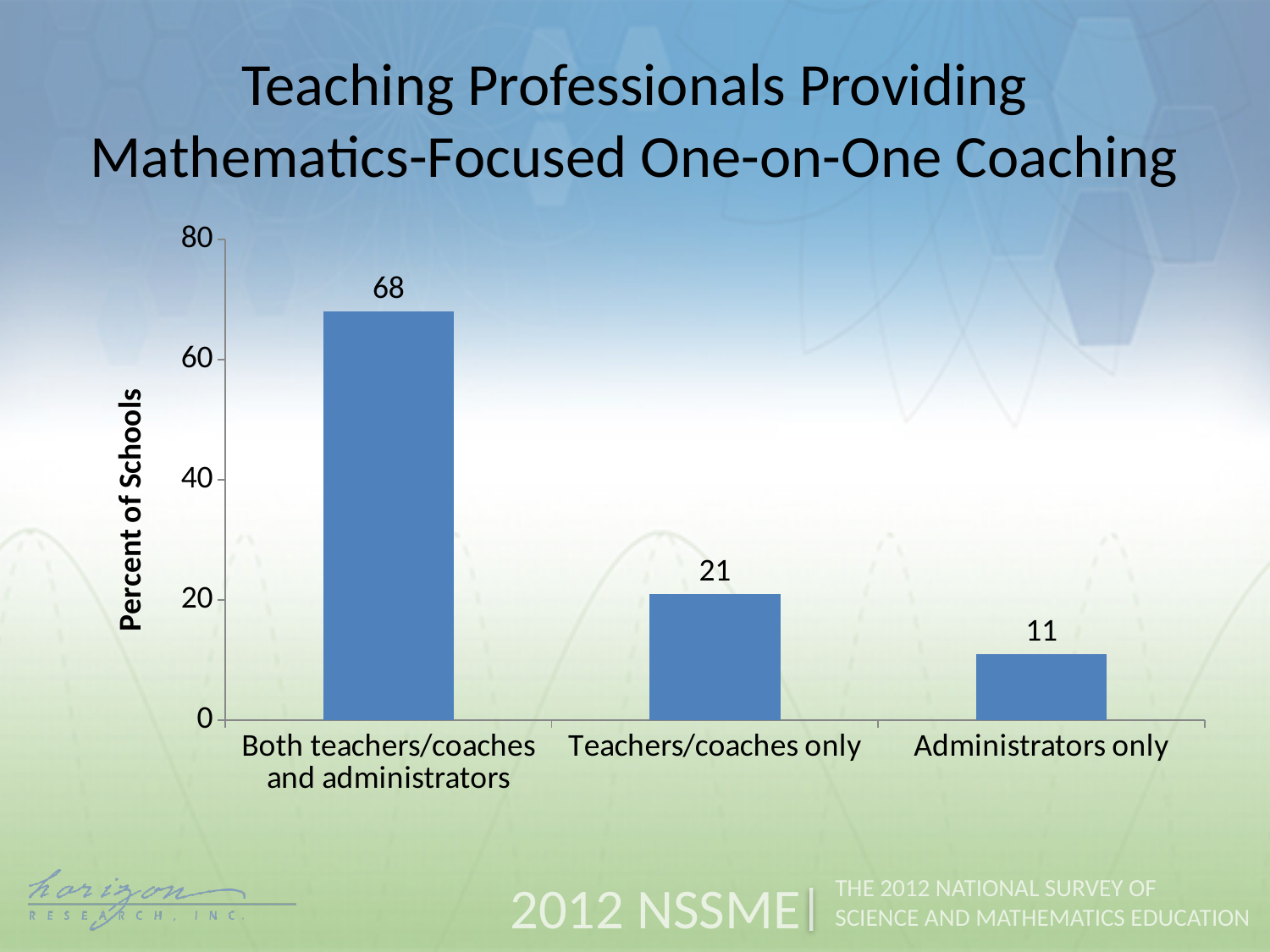
Is the value for Both teachers/coaches and administrators greater or less than 60? greater What kind of chart is shown on the slide? Bar chart How many categories are shown on the x axis? 3 Which is larger: the value for Teachers/coaches only or Administrators only? Teachers/coaches only What is the difference between the values for Teachers/coaches only and Administrators only? 10 What is the value for Teachers/coaches only? 21 What is the label of the y axis? Percent of Schools What is the value for Administrators only? 11 What percent of schools have both teachers/coaches and administrators providing mathematics-focused one-on-one coaching? 68 Which category has the highest percent of schools? Both teachers/coaches and administrators What is the difference between the values for Both teachers/coaches and administrators and Teachers/coaches only? 47 Which category has the lowest percent of schools? Administrators only